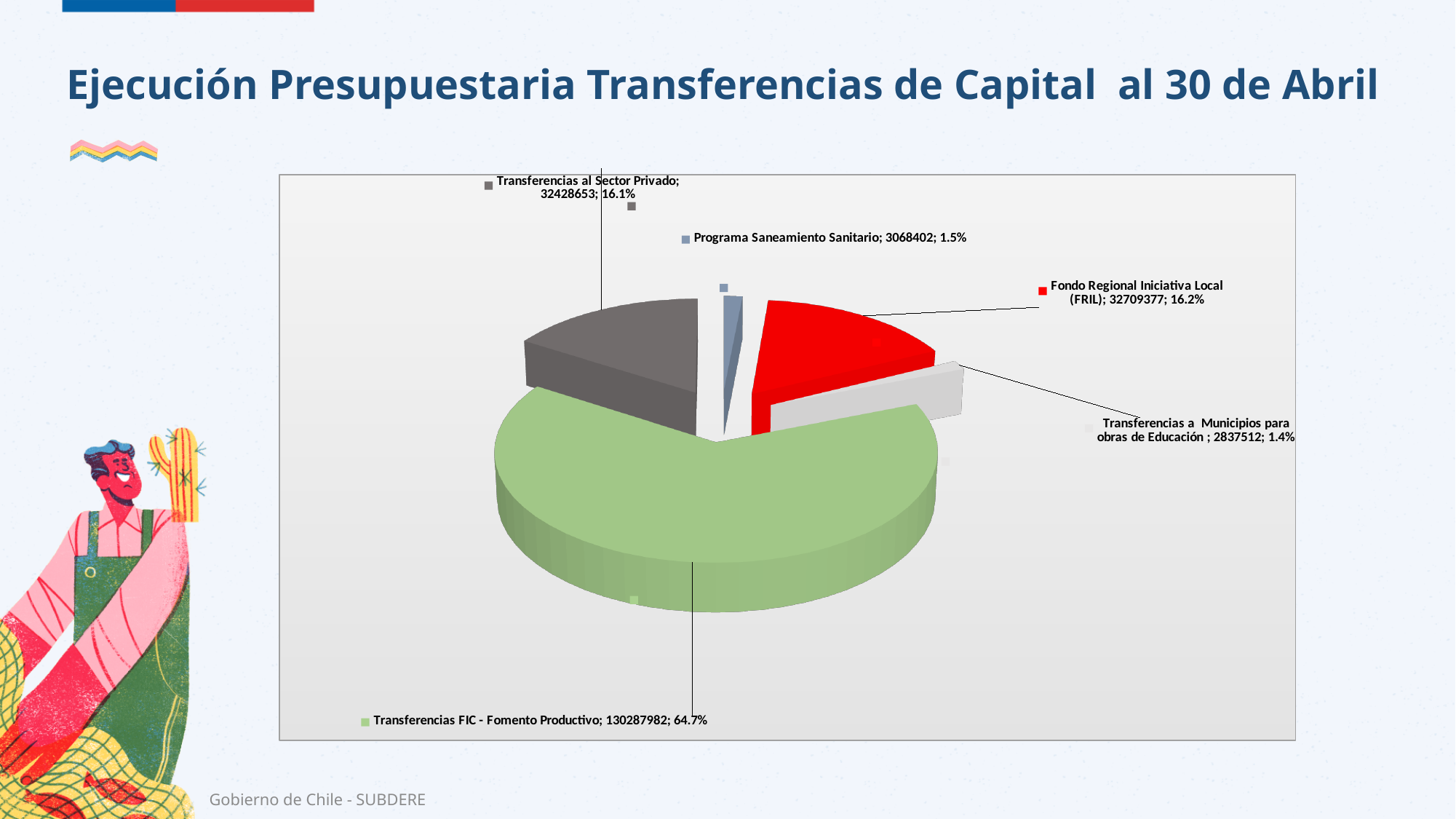
Which has a larger value, Programa Saneamiento Sanitario or Transferencias a Municipios para obras de Educación? Programa Saneamiento Sanitario What share of the pie does Transferencias a Municipios para obras de Educación represent? 1.4% Which category has the largest slice of the pie? Transferencias FIC - Fomento Productivo What share of the pie does Transferencias al Sector Privado represent? 16.1% Which category has the smallest slice of the pie? Transferencias a Municipios para obras de Educación What is the value for Fondo Regional Iniciativa Local (FRIL)? 32709377 How many slices does the pie chart have? 5 What kind of chart is shown on the slide? Pie chart What is the title of the slide containing the chart? Ejecución Presupuestaria Transferencias de Capital al 30 de Abril What is the difference between the values for Fondo Regional Iniciativa Local (FRIL) and Transferencias al Sector Privado? 280724 What is the value for Programa Saneamiento Sanitario? 3068402 What is the value for Transferencias FIC - Fomento Productivo? 130287982